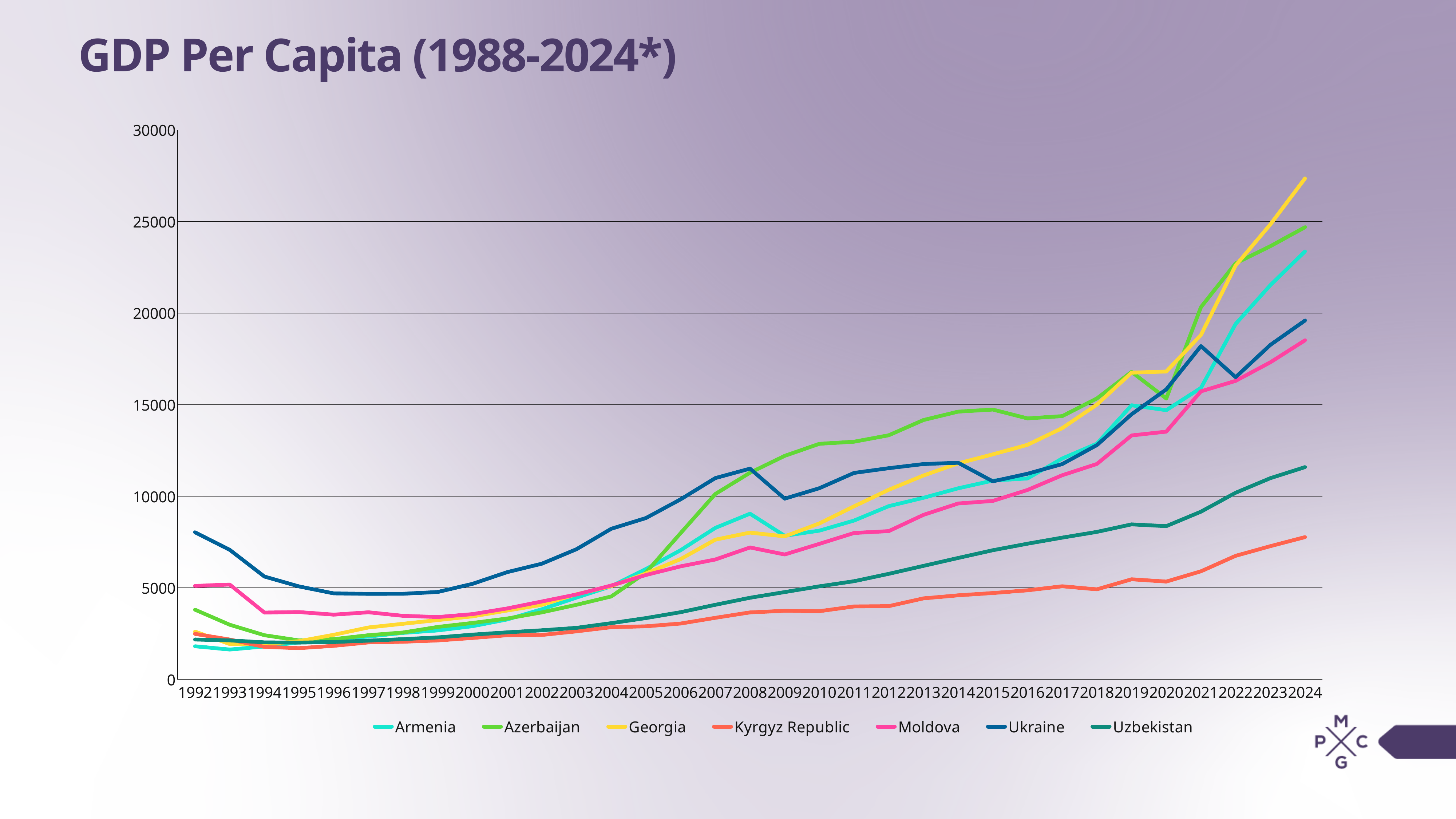
Which country has the lowest GDP per capita in 2024? Kyrgyz Republic Which country has the highest GDP per capita in 2024? Georgia Which country has the highest GDP per capita in 1992? Ukraine Is the value for Georgia in 2024 greater or less than 25000? greater What is the title of the chart? GDP Per Capita (1988-2024*) Is the value for Kyrgyz Republic in 2024 greater or less than 10000? less How many series does the legend list? 7 How many years are shown along the x axis? 33 Is the value for Uzbekistan in 2024 greater or less than 10000? greater In 2024, which is larger: the value for Azerbaijan or the value for Moldova? Azerbaijan Does the Kyrgyz Republic line generally rise or fall from 1992 to 2024? rise What kind of chart is shown on the slide? line chart